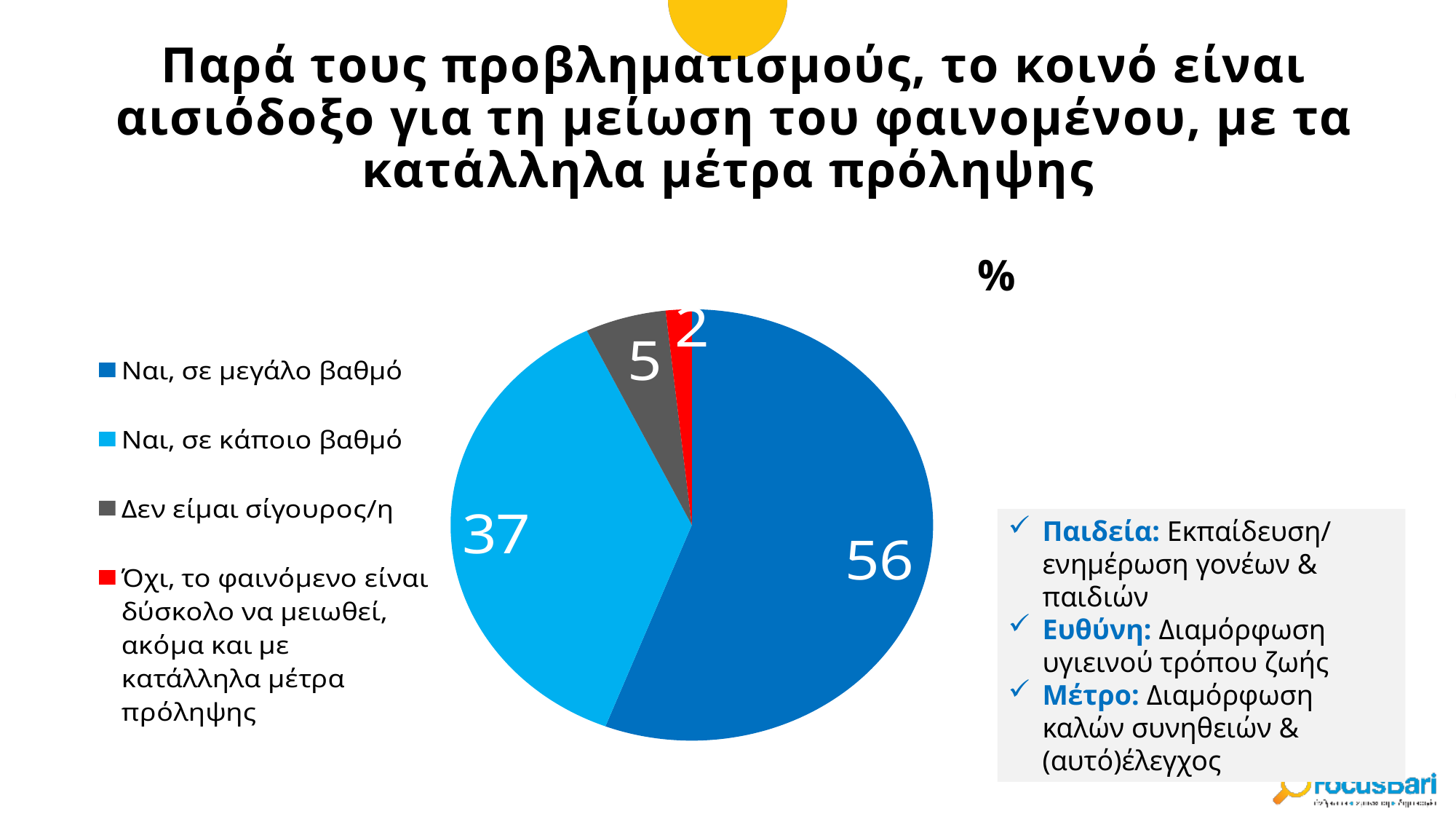
Which category has the smallest slice of the pie? Όχι, το φαινόμενο είναι δύσκολο να μειωθεί, ακόμα και με κατάλληλα μέτρα πρόληψης How many slices does the pie chart have? 4 What kind of chart is shown on the slide? pie chart How many entries does the legend of the pie chart list? 4 What is the value shown for "Δεν είμαι σίγουρος/η"? 5 What is the value shown for "Ναι, σε κάποιο βαθμό"? 37 What is the value shown for "Ναι, σε μεγάλο βαθμό"? 56 What is the value shown for "Όχι, το φαινόμενο είναι δύσκολο να μειωθεί, ακόμα και με κατάλληλα μέτρα πρόληψης"? 2 Which is larger: the value for "Δεν είμαι σίγουρος/η" or the value for "Όχι, το φαινόμενο είναι δύσκολο να μειωθεί, ακόμα και με κατάλληλα μέτρα πρόληψης"? Δεν είμαι σίγουρος/η What is the difference between the values for "Ναι, σε μεγάλο βαθμό" and "Ναι, σε κάποιο βαθμό"? 19 Which category has the largest slice of the pie? Ναι, σε μεγάλο βαθμό What colour is the slice for "Δεν είμαι σίγουρος/η"? grey